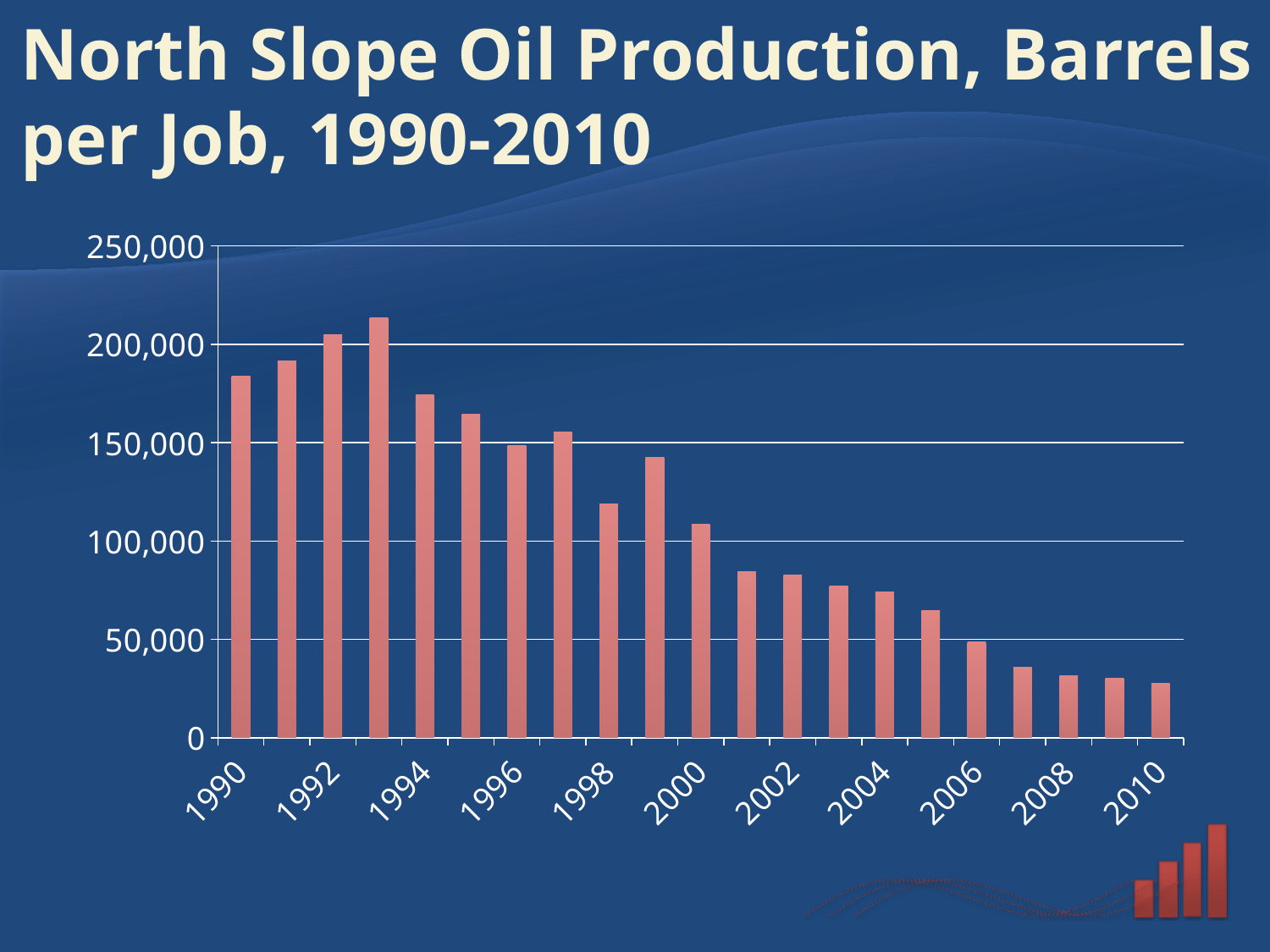
Is the value for 2008 greater or less than 50,000? less Is the value for 2000 greater or less than 100,000? greater How many bars (years) are plotted in the chart? 21 Is the value for 1998 greater or less than 100,000? greater Which labeled year has the lowest value in the chart? 2010 Which year has the larger value, 2000 or 2002? 2000 What is the title of the chart? North Slope Oil Production, Barrels per Job, 1990-2010 What kind of chart is shown on the slide? bar chart Which year has the larger value, 1994 or 2004? 1994 Do the values generally rise or fall from 1990 to 2010? fall